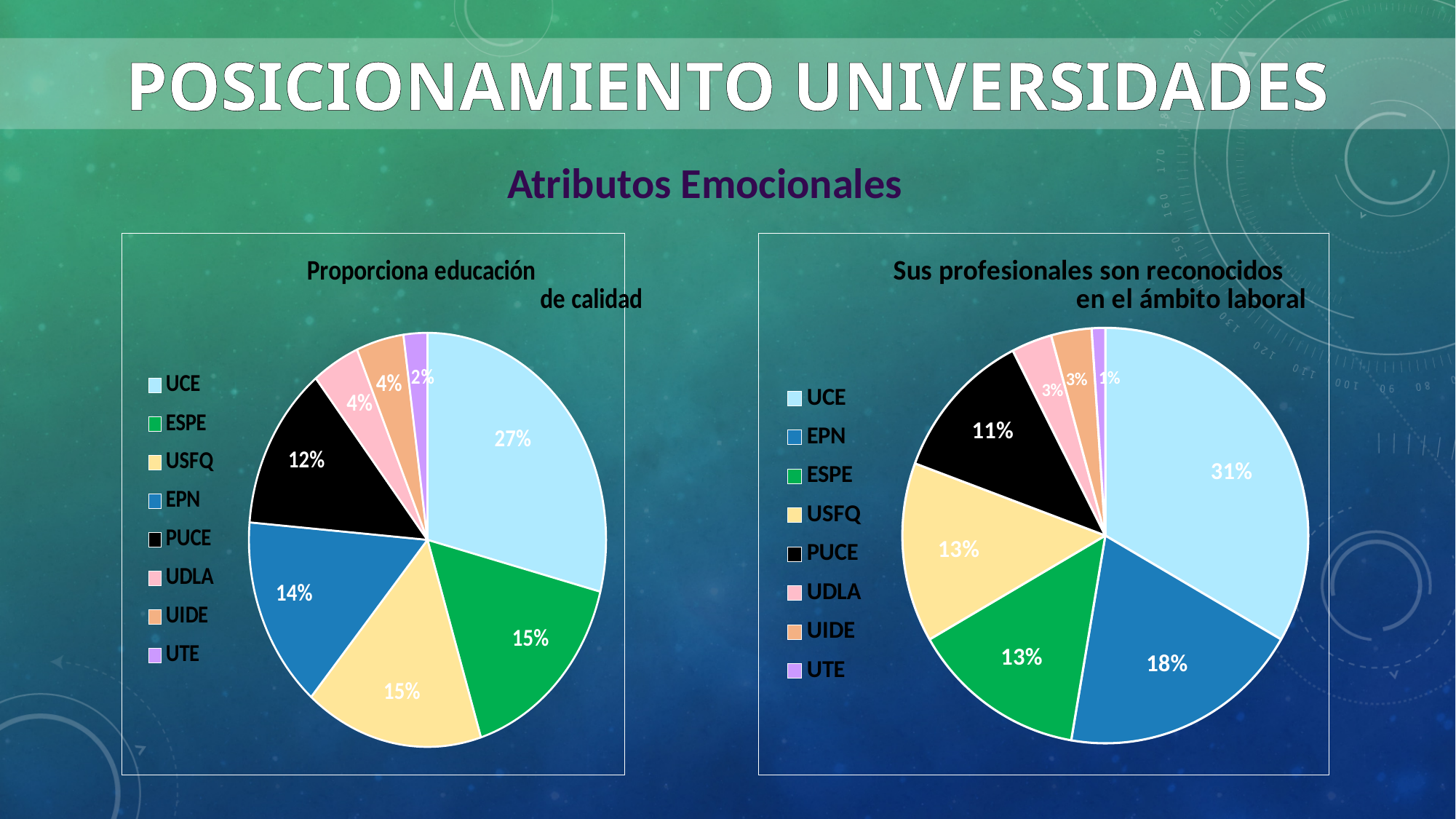
In the 'Sus profesionales son reconocidos en el ámbito laboral' chart, which university has the largest slice? UCE How many universities are listed in the legend of the 'Sus profesionales son reconocidos en el ámbito laboral' chart? 8 What type of chart is the 'Proporciona educación de calidad' chart? Pie chart In the 'Proporciona educación de calidad' chart, which university has the largest slice? UCE What colour represents PUCE in both charts? Black In the 'Proporciona educación de calidad' chart, what share does UCE have? 27% In the 'Sus profesionales son reconocidos en el ámbito laboral' chart, what is the difference between UCE's share and EPN's share? 13% In the 'Proporciona educación de calidad' chart, which university has the smallest slice? UTE In the 'Sus profesionales son reconocidos en el ámbito laboral' chart, what share does UTE have? 1% In the 'Sus profesionales son reconocidos en el ámbito laboral' chart, what share does EPN have? 18% In the 'Proporciona educación de calidad' chart, which is larger, the share for EPN or the share for PUCE? EPN In the 'Proporciona educación de calidad' chart, what share does PUCE have? 12%